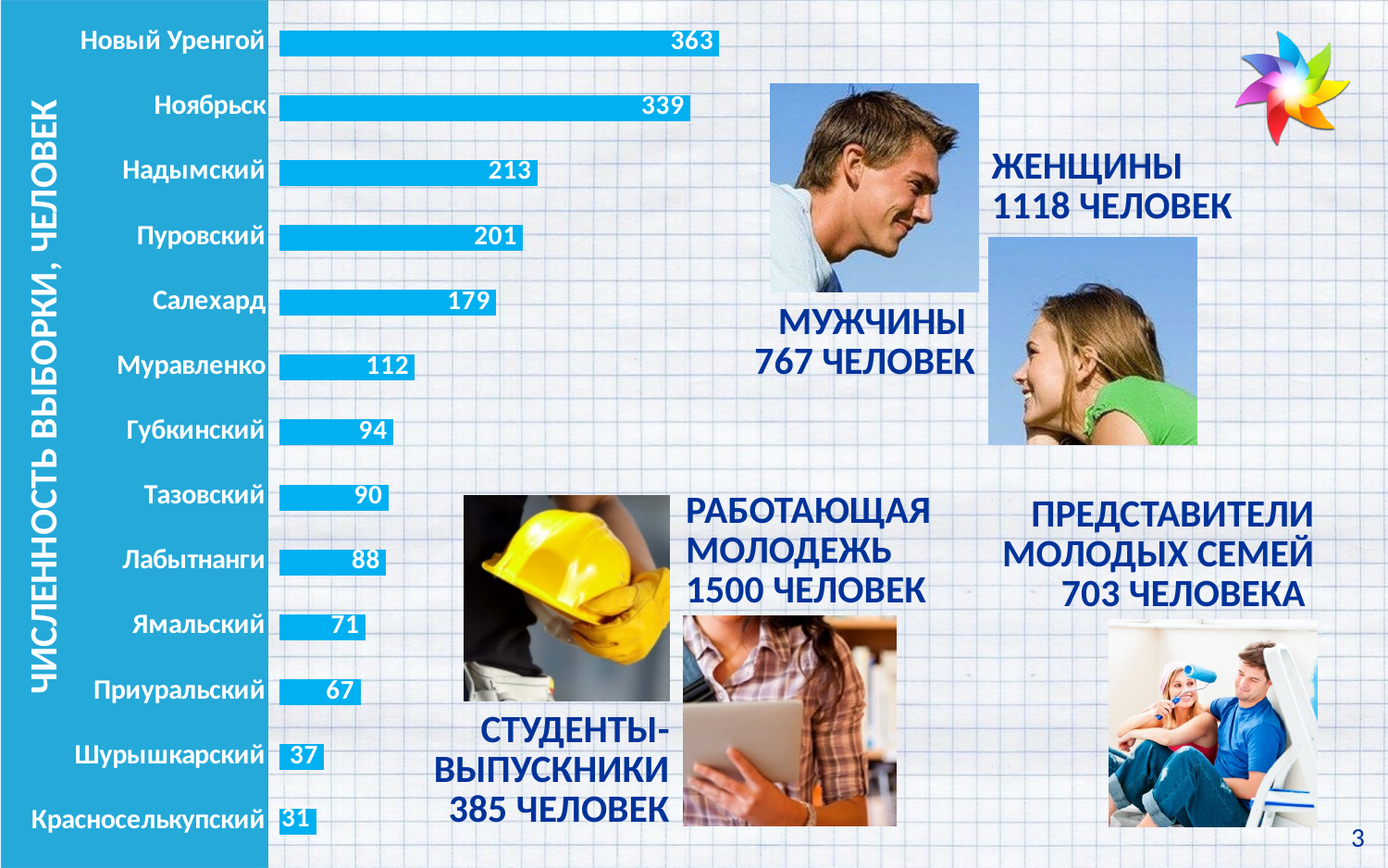
Which is larger, the value for Муравленко or the value for Губкинский? Муравленко Which category has the lowest value? Красноселькупский What is the title of the bar chart? ЧИСЛЕННОСТЬ ВЫБОРКИ, ЧЕЛОВЕК What is the value for Новый Уренгой? 363 What type of chart is shown on the slide? bar chart What is the difference between the values for Надымский and Пуровский? 12 What is the value for Салехард? 179 What is the value for Шурышкарский? 37 What is the difference between the values for Новый Уренгой and Ноябрьск? 24 How many categories are shown in the bar chart? 13 Which category has the highest value? Новый Уренгой What is the value for Лабытнанги? 88